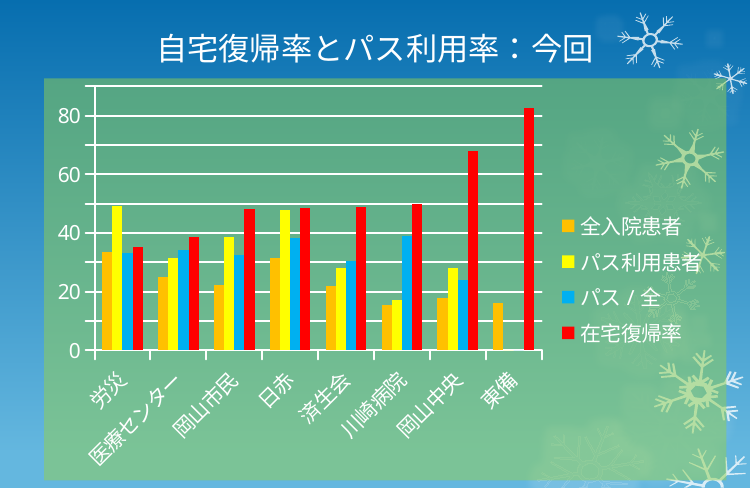
Which is larger, the 在宅復帰率 value for 岡山中央 or for 済生会? 岡山中央 Is the 在宅復帰率 value for 東備 greater or less than 80? greater What is the title of the chart? 自宅復帰率とパス利用率：今回 Which is larger, the 在宅復帰率 value for 東備 or for 労災? 東備 Is the パス利用患者 value for 労災 greater or less than 40? greater Which category has the highest 在宅復帰率 value? 東備 What kind of chart is shown on the slide? bar chart Is the 在宅復帰率 value for 労災 greater or less than 40? less How many series does the legend list? 4 How many hospital categories are shown on the x axis? 8